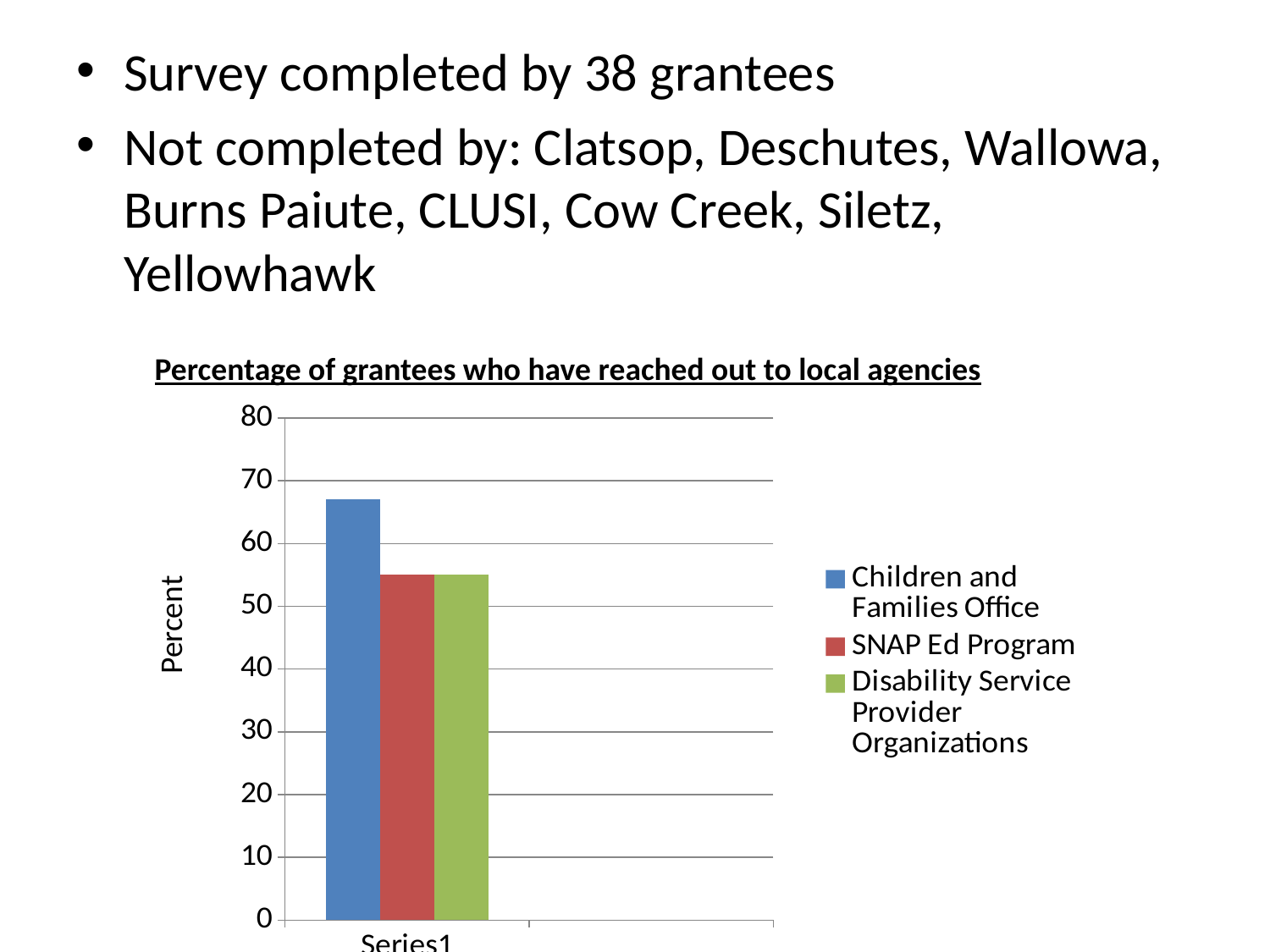
Is the value for SNAP Ed Program greater or less than 50? greater Is the value for Children and Families Office greater or less than 70? less How many series does the chart's legend list? 3 Which is larger, the value for Children and Families Office or the value for Disability Service Provider Organizations? Children and Families Office Which series has the highest bar in the chart? Children and Families Office What kind of chart is shown on the slide? bar chart Which is larger, the value for Children and Families Office or the value for SNAP Ed Program? Children and Families Office Is the value for SNAP Ed Program greater or less than 60? less What is the label on the vertical axis of the chart? Percent What is the title of the chart? Percentage of grantees who have reached out to local agencies